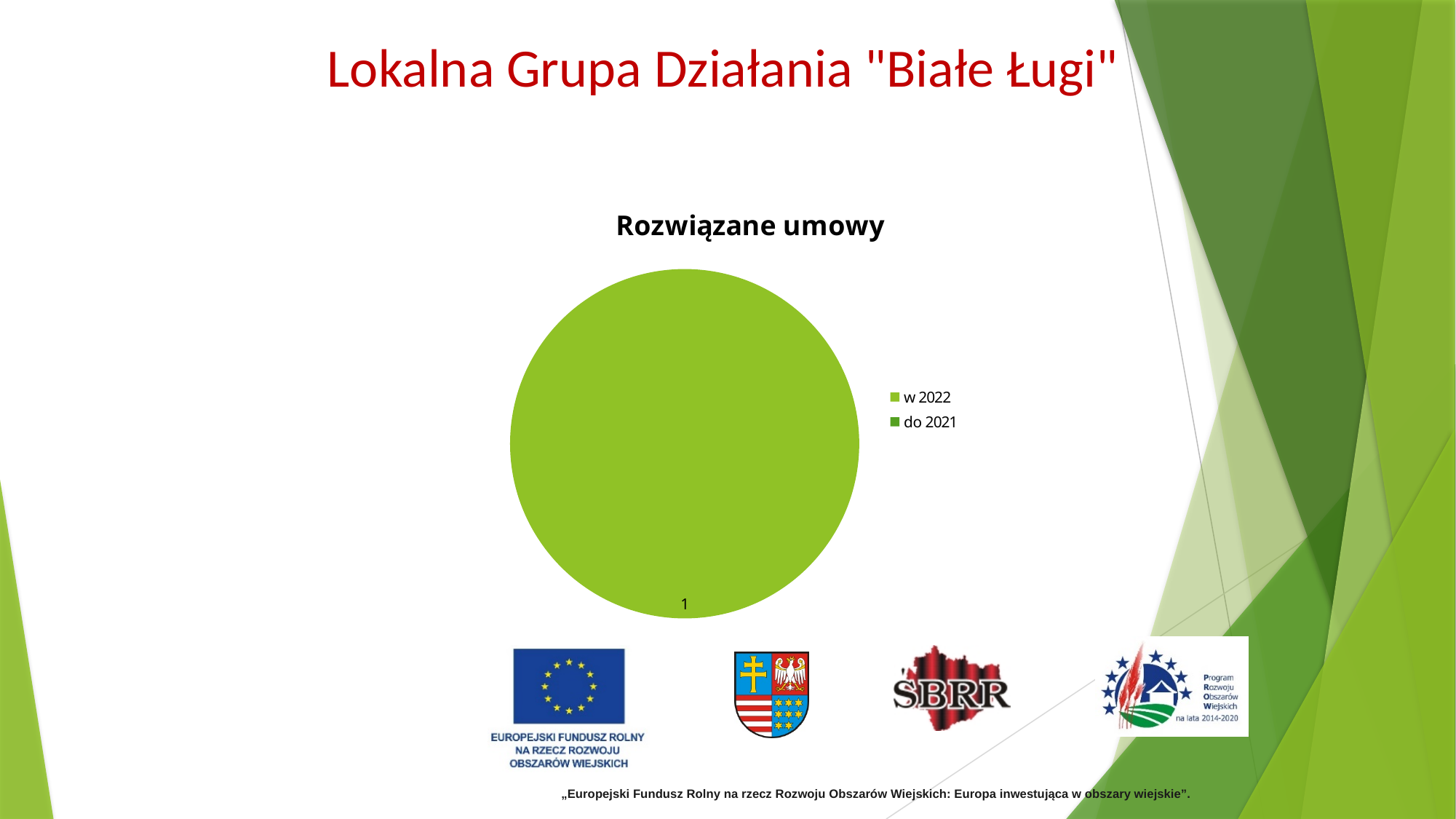
What data label value is printed on the pie? 1 How many slices are visibly drawn in the pie? 1 How many entries does the chart's legend list? 2 What kind of chart is shown on the slide? pie chart What are the two entries listed in the chart's legend? w 2022 and do 2021 What is the title of the chart? Rozwiązane umowy